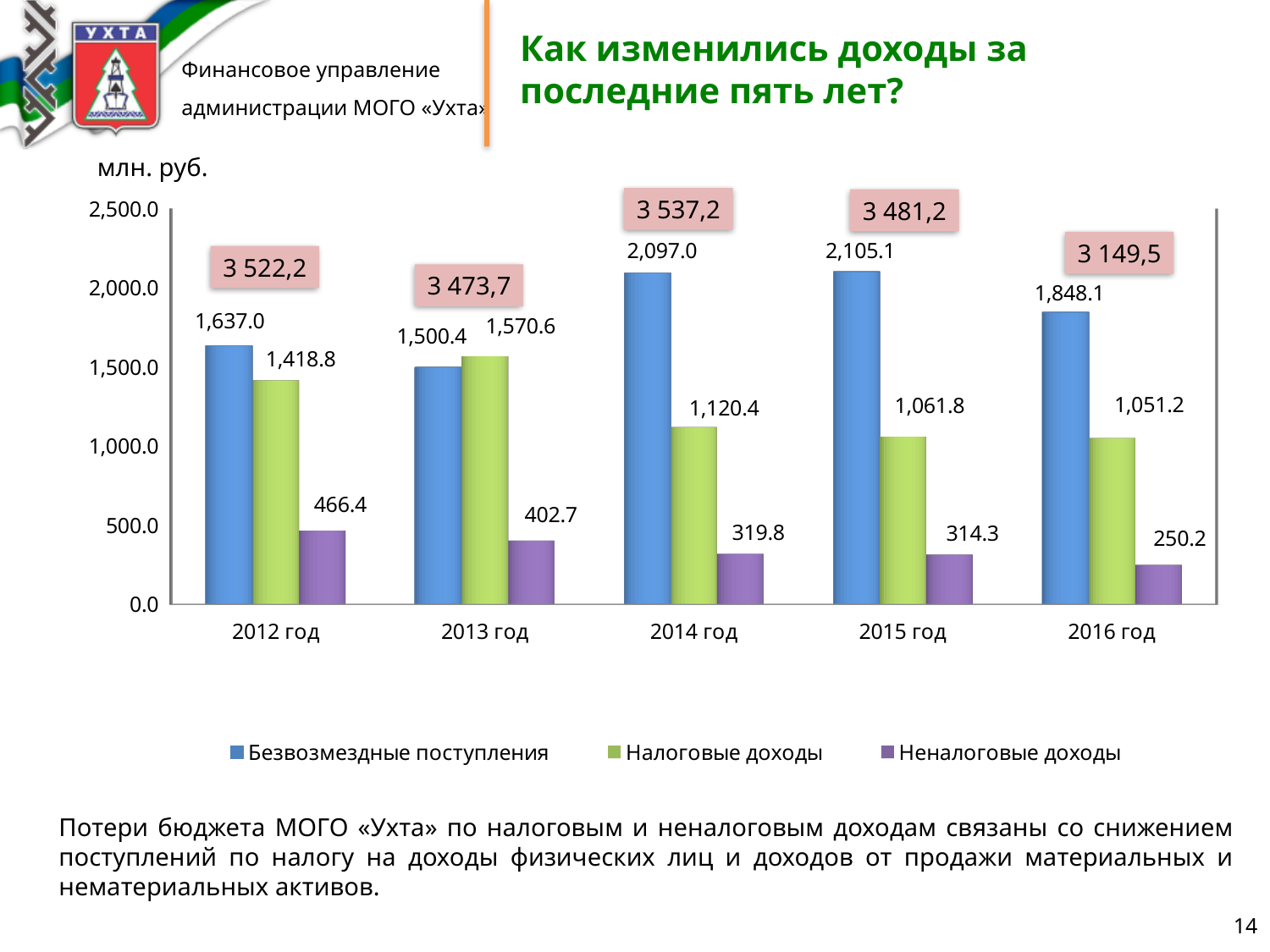
Which is larger in 2013 год: Безвозмездные поступления or Налоговые доходы? Налоговые доходы How many years are shown on the x axis? 5 What kind of chart is shown on the slide? bar chart What is the difference between Безвозмездные поступления and Налоговые доходы in 2012 год? 218.2 What is the value of Неналоговые доходы for 2016 год? 250.2 In which year is Безвозмездные поступления highest? 2015 год What is the value of Безвозмездные поступления for 2014 год? 2,097.0 What is the value of Налоговые доходы for 2013 год? 1,570.6 Do the values of Неналоговые доходы rise or fall from 2012 год to 2016 год? fall In which year is Неналоговые доходы lowest? 2016 год How many series does the legend list? 3 Is the value of Налоговые доходы for 2015 год greater or less than 1,000.0? greater